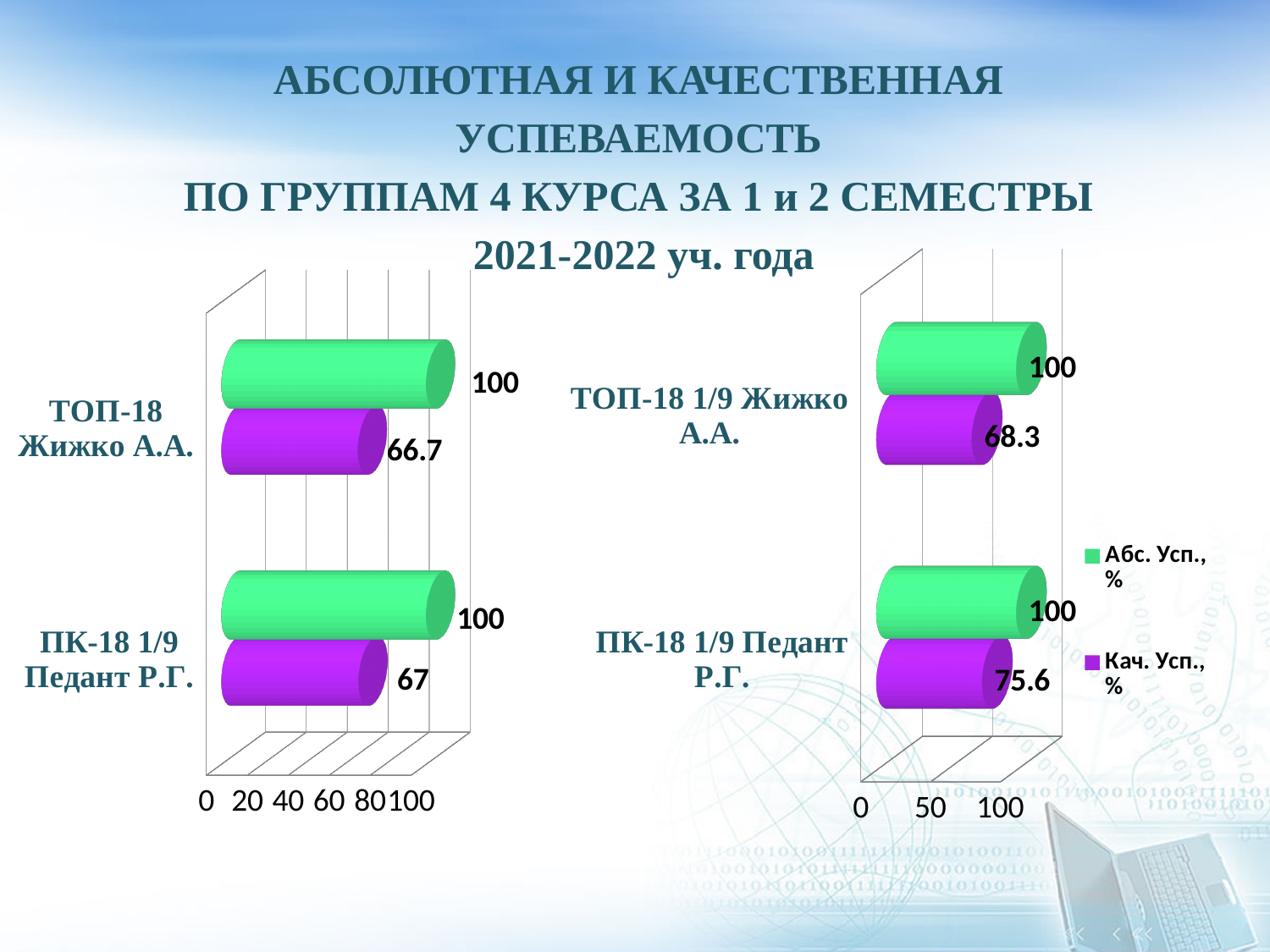
In the right chart, what is the difference between the Абс. Усп., % and Кач. Усп., % values for ПК-18 1/9 Педант Р.Г.? 24.4 In the left chart, what is the Кач. Усп., % (purple) value for ТОП-18 Жижко А.А.? 66.7 How many series does the legend of the right chart list? 2 In the left chart, what is the Кач. Усп., % (purple) value for ПК-18 1/9 Педант Р.Г.? 67 In the right chart, what is the Кач. Усп., % value for ТОП-18 1/9 Жижко А.А.? 68.3 How many groups (categories) are shown in the right chart? 2 What type of chart is the left chart? Bar chart In the right chart, is the Кач. Усп., % value for ПК-18 1/9 Педант Р.Г. greater or less than 50? greater In the right chart, what is the Кач. Усп., % value for ПК-18 1/9 Педант Р.Г.? 75.6 In the left chart, what is the difference between the green and purple values for ТОП-18 Жижко А.А.? 33.3 In the right chart, which group has the higher Кач. Усп., % value? ПК-18 1/9 Педант Р.Г. In the right chart, what is the Абс. Усп., % value for ТОП-18 1/9 Жижко А.А.? 100